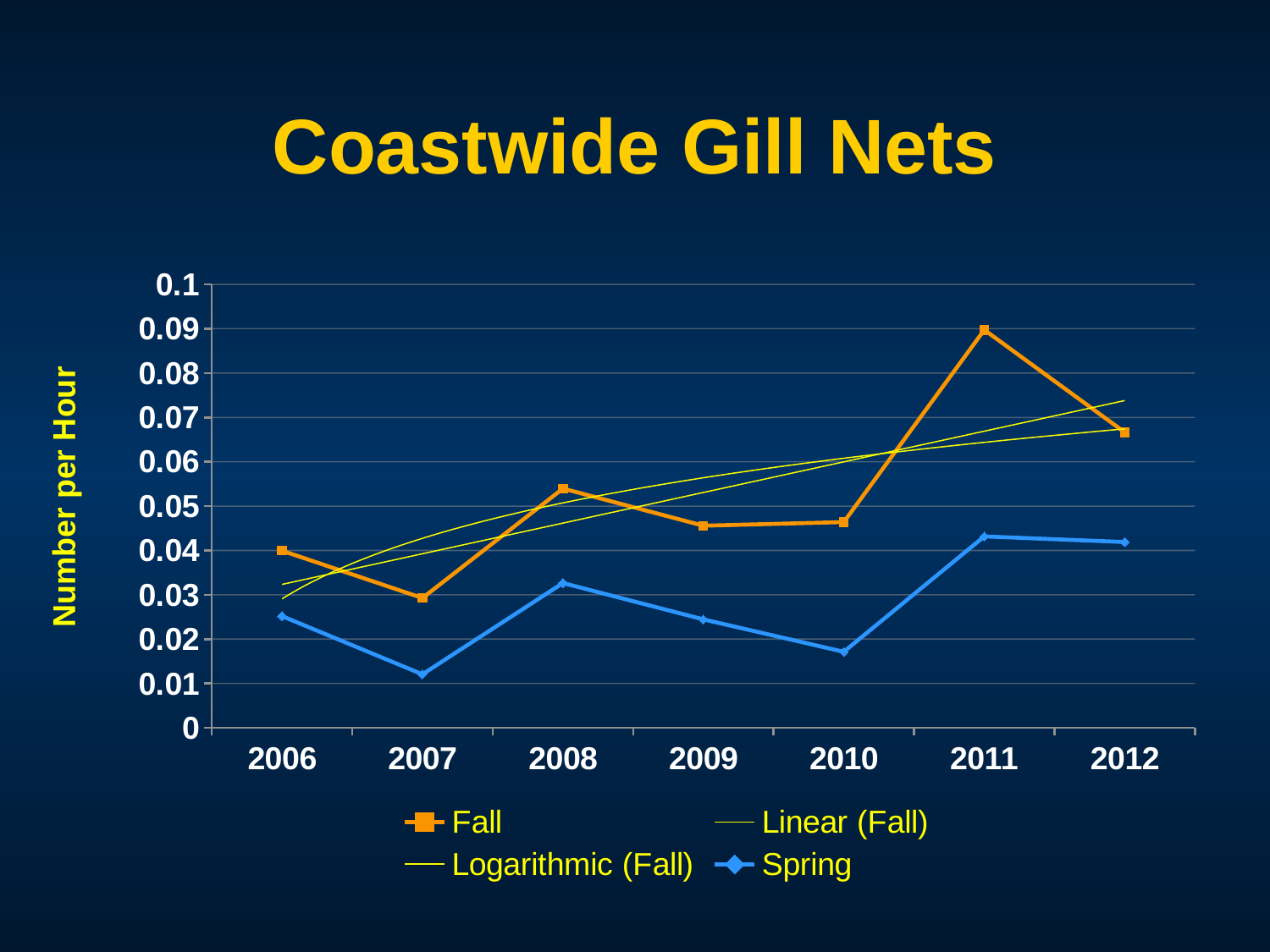
In which year is the Spring value lowest? 2007 Is the Spring value for 2007 greater or less than 0.02? less Which series has the larger value in 2008, Fall or Spring? Fall Is the Fall value for 2009 greater or less than 0.05? less In which year is the Fall value lowest? 2007 Is the Fall value for 2011 greater or less than 0.08? greater How many years are plotted along the x axis? 7 How many series does the legend list? 4 What is the title of the y axis? Number per Hour Which year has the larger Fall value, 2011 or 2012? 2011 In which year is the Fall value highest? 2011 What kind of chart is shown on the slide? line chart